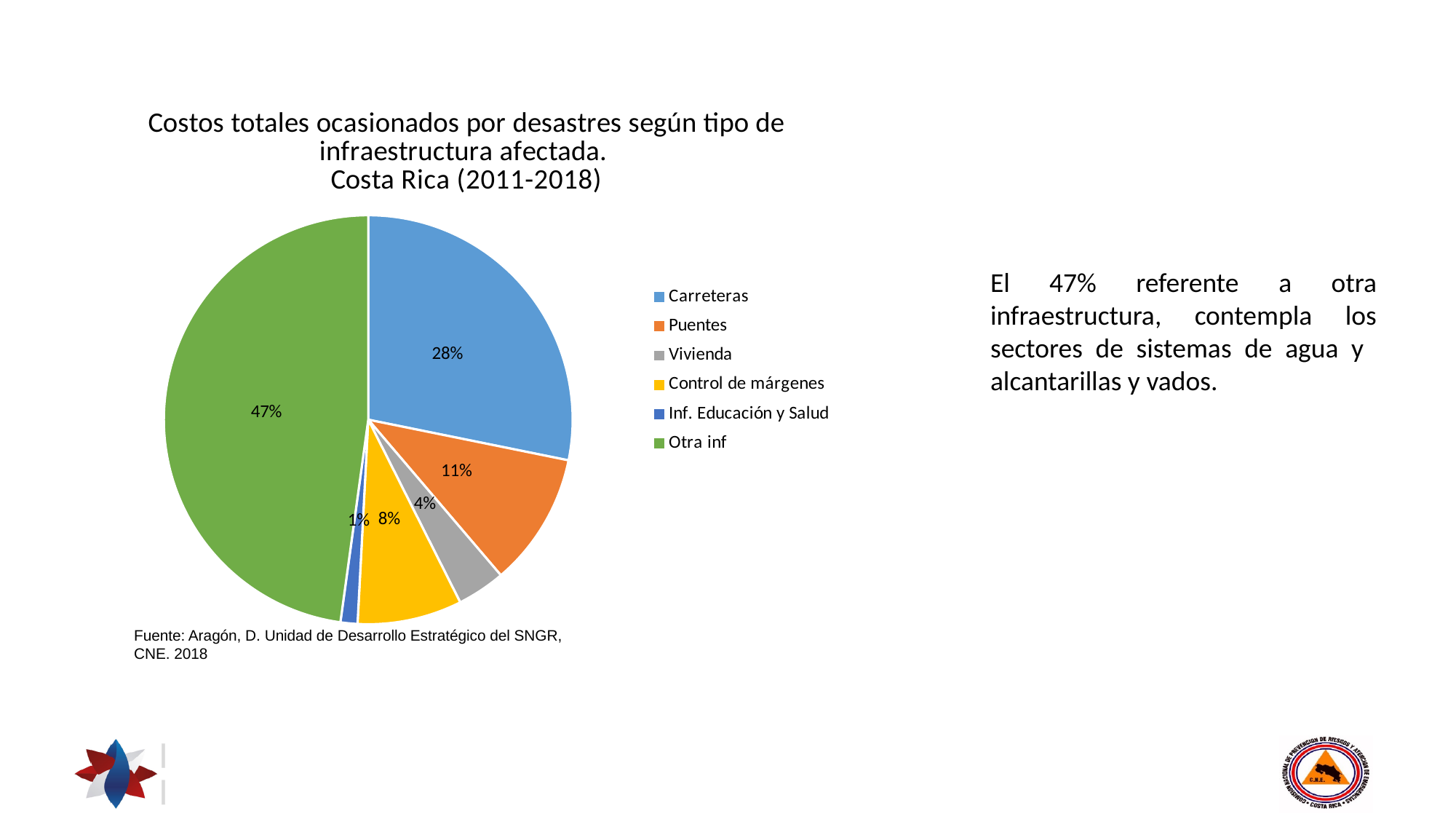
What share of total disaster costs corresponds to Control de márgenes? 8% What share of total disaster costs corresponds to Vivienda? 4% What colour is the Otra inf slice? green What share of total disaster costs corresponds to Puentes? 11% Which category accounts for the smallest share of disaster costs? Inf. Educación y Salud What is the difference in percentage points between the Otra inf share and the Carreteras share? 19 Which has a larger share, Puentes or Control de márgenes? Puentes Which category accounts for the largest share of disaster costs? Otra inf What type of chart is shown on the slide? pie chart How many categories does the legend list? 6